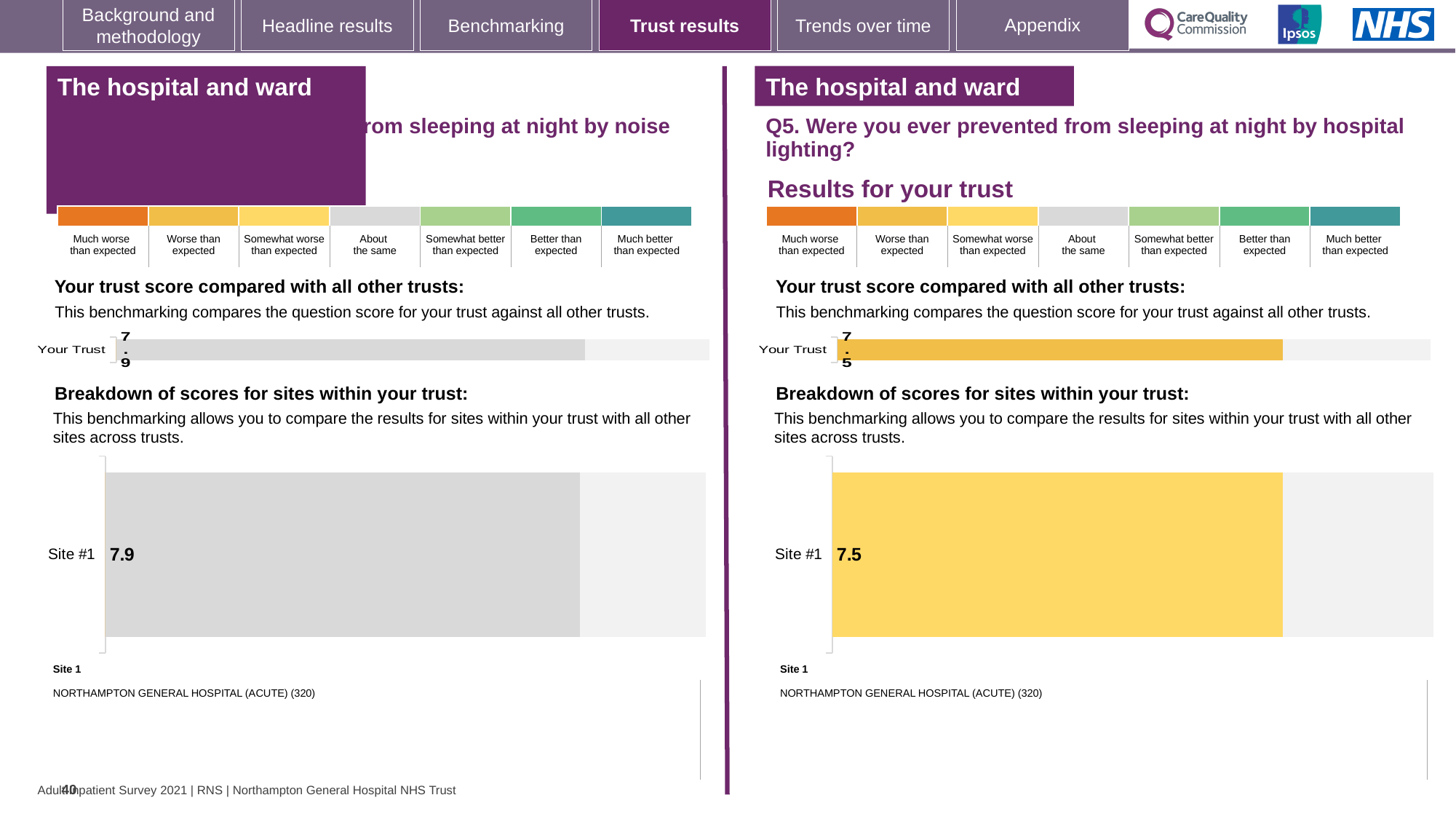
Which is larger: the Your Trust score on the left half of the slide or the Your Trust score on the right half (Q5)? Left half (7.9) On the right half of the slide (Q5), is the Your Trust score greater or less than 7? greater On the right half of the slide (Q5), what colour is the Your Trust bar? Yellow What type of chart is used to show the Site #1 score on the right half of the slide? Bar chart On the left half of the slide (sleeping at night by noise), what score is shown for Site #1? 7.9 Which site is listed as Site 1 on the right half of the slide? NORTHAMPTON GENERAL HOSPITAL (ACUTE) (320) On the right half of the slide (Q5, hospital lighting), what score is shown for Site #1? 7.5 What is the difference between the Site #1 score on the left half of the slide and the Site #1 score on the right half (Q5)? 0.4 On the left half of the slide (sleeping at night by noise), what is the score shown for Your Trust? 7.9 On the left half of the slide, what colour is the Site #1 bar? Grey How many sites are shown in the breakdown of scores chart on the right half of the slide? 1 On the right half of the slide (Q5, hospital lighting), what is the score shown for Your Trust? 7.5